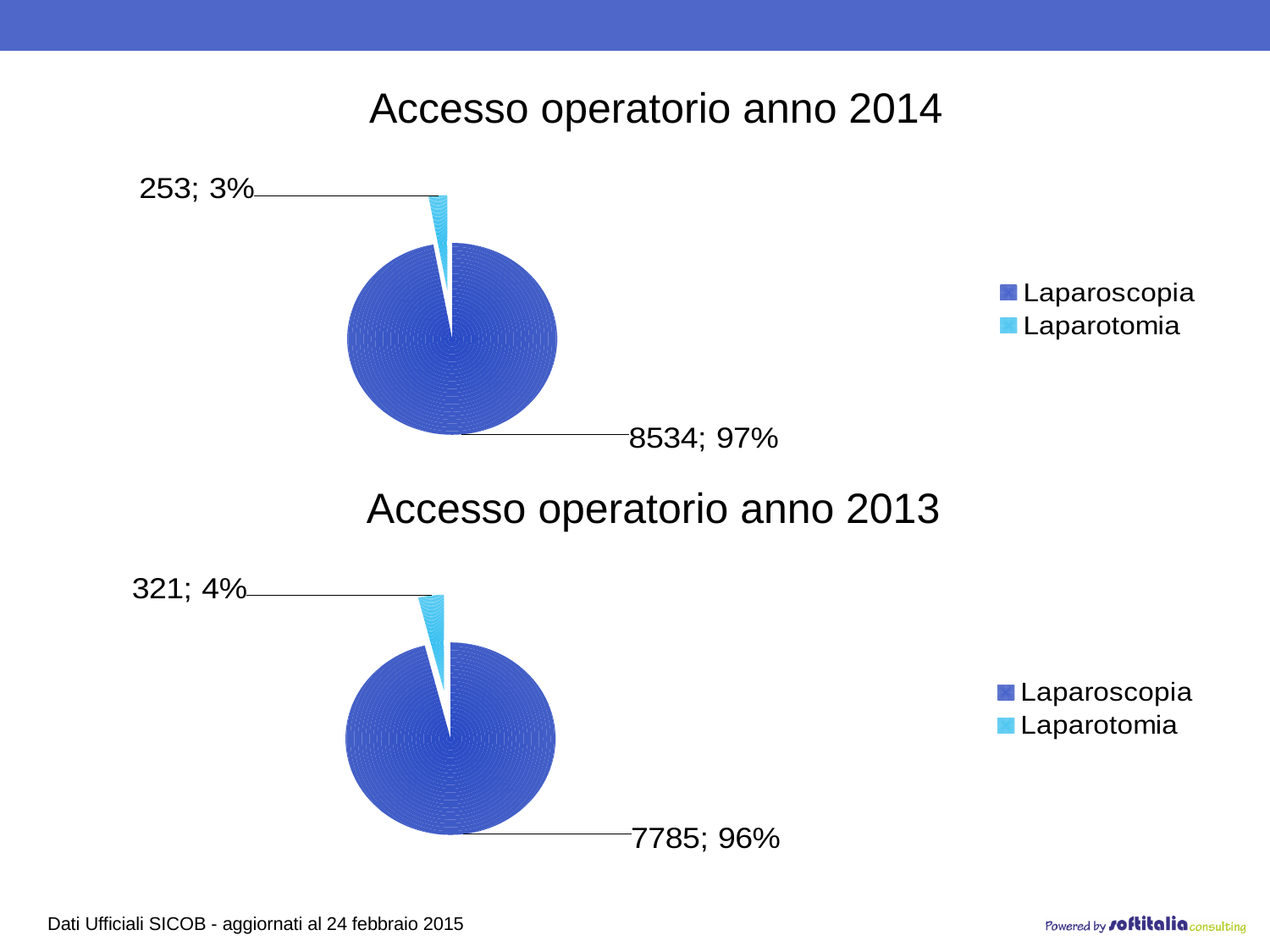
What kind of chart is 'Accesso operatorio anno 2013'? Pie chart In the 'Accesso operatorio anno 2014' chart, what is the difference between the Laparoscopia and Laparotomia values? 8281 In the 'Accesso operatorio anno 2014' chart, which category is the largest? Laparoscopia In the 'Accesso operatorio anno 2013' chart, what is the value for Laparoscopia? 7785 In the 'Accesso operatorio anno 2014' chart, what share of the pie does Laparotomia represent? 3% In the 'Accesso operatorio anno 2013' chart, what share of the pie does Laparoscopia represent? 96% In the 'Accesso operatorio anno 2013' chart, which category is the smallest? Laparotomia In the 'Accesso operatorio anno 2014' chart, what is the value for Laparoscopia? 8534 In the 'Accesso operatorio anno 2014' chart, what is the value for Laparotomia? 253 How many categories does the 'Accesso operatorio anno 2014' chart show? 2 In the 'Accesso operatorio anno 2013' chart, which colour represents Laparotomia? Light blue In the 'Accesso operatorio anno 2013' chart, what is the value for Laparotomia? 321